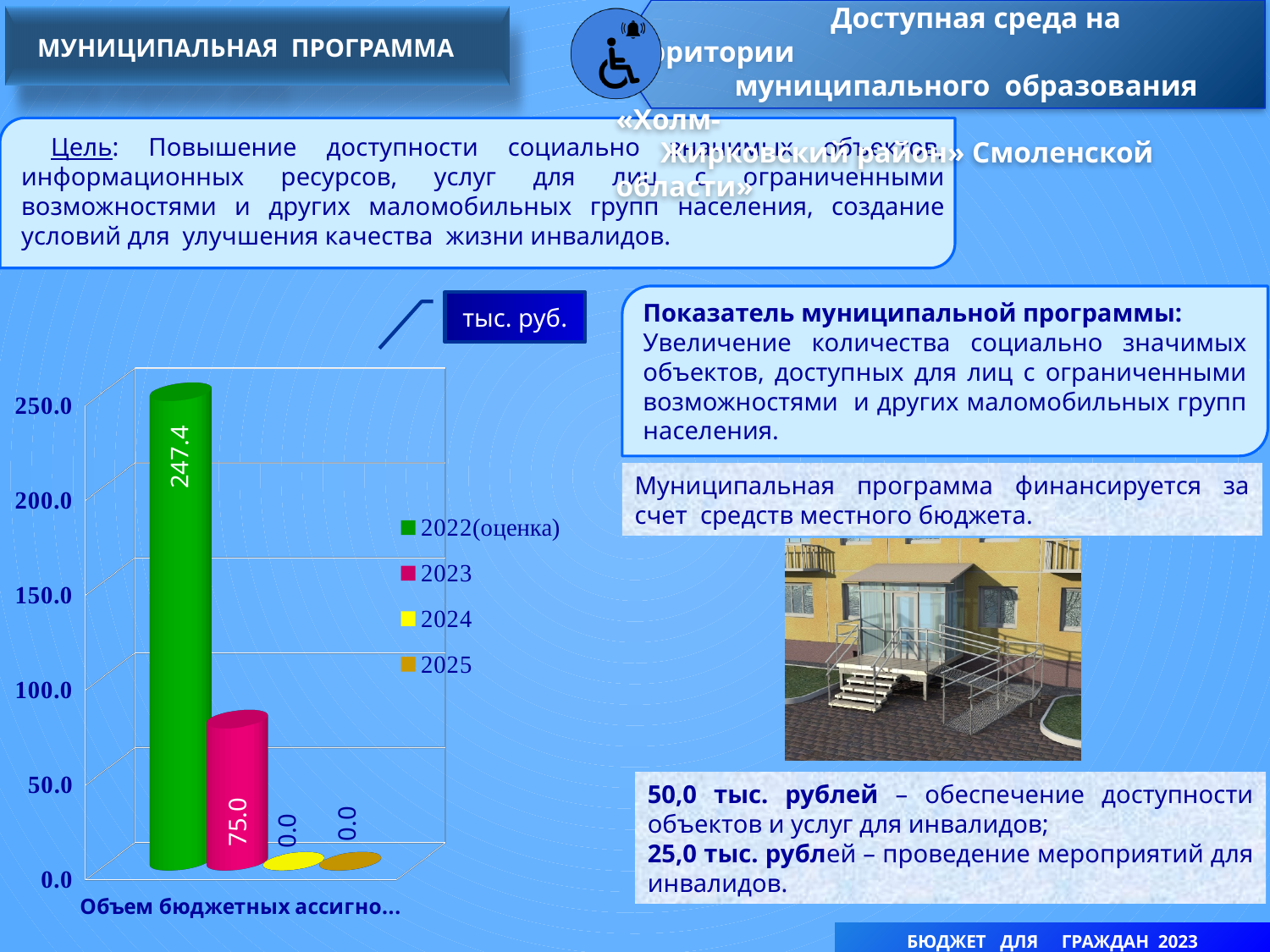
Which is larger, the value for 2022(оценка) or the value for 2023? 2022(оценка) What unit is indicated for the chart values? тыс. руб. How many series does the chart legend list? 4 What is the value for 2024 on the chart? 0.0 What is the value for 2022(оценка) on the chart? 247.4 Is the value for 2022(оценка) greater or less than 200.0? greater Is the value for 2023 greater or less than 100.0? less What is the value for 2025 on the chart? 0.0 What is the difference between the values for 2022(оценка) and 2023? 172.4 What is the value for 2023 on the chart? 75.0 What kind of chart is shown on the slide? bar chart Which series has the highest value on the chart? 2022(оценка)